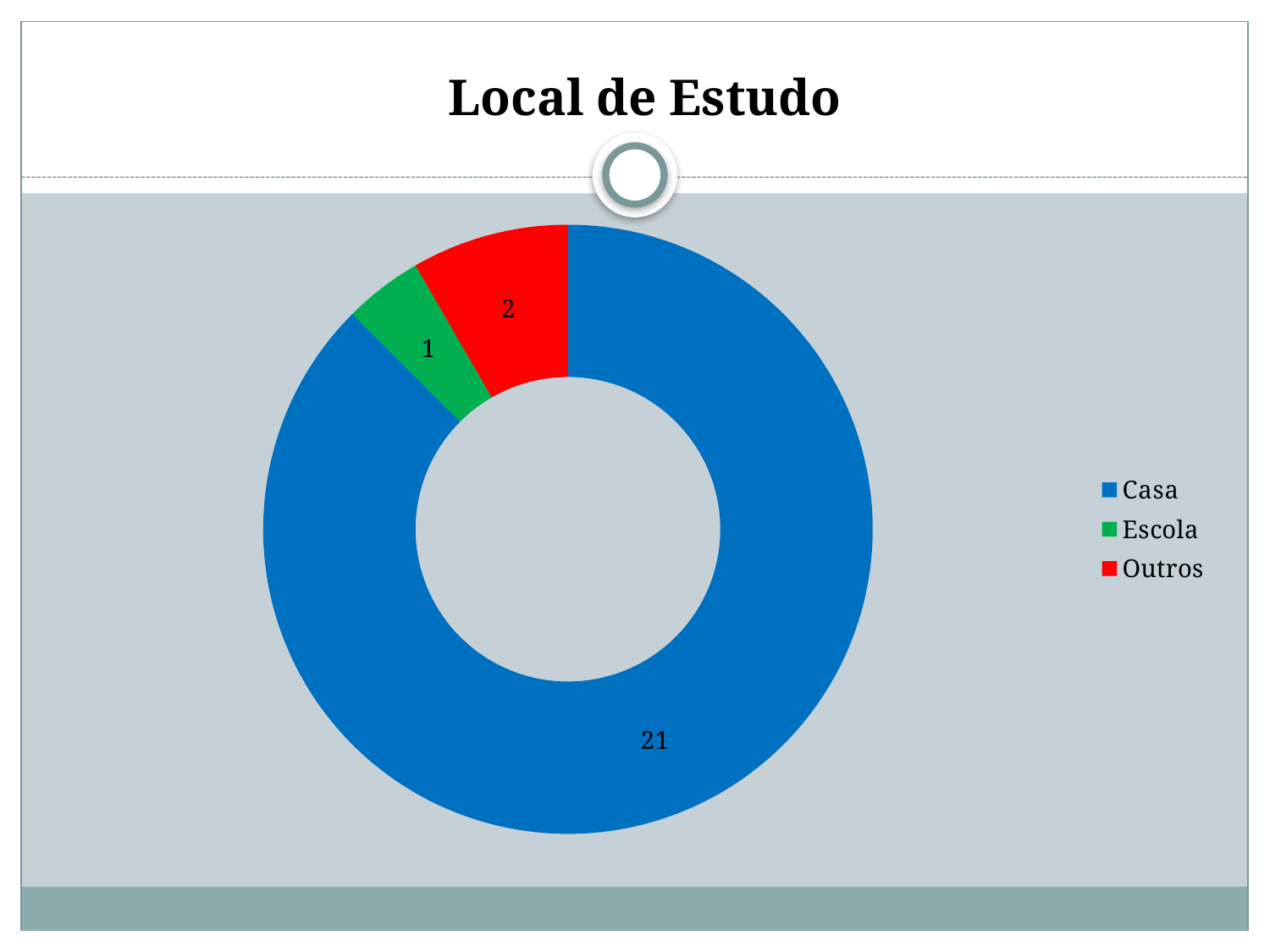
What is the title of the chart? Local de Estudo What kind of chart is shown on the slide? Doughnut chart What is the difference between the values for Outros and Escola? 1 What is the value for Casa? 21 What is the value for Escola? 1 What is the difference between the values for Casa and Outros? 19 Which category has the lowest value? Escola What is the total of all the values in the chart? 24 Which category has the highest value? Casa What is the value for Outros? 2 How many categories are shown in the chart? 3 Which is larger, the value for Outros or the value for Escola? Outros